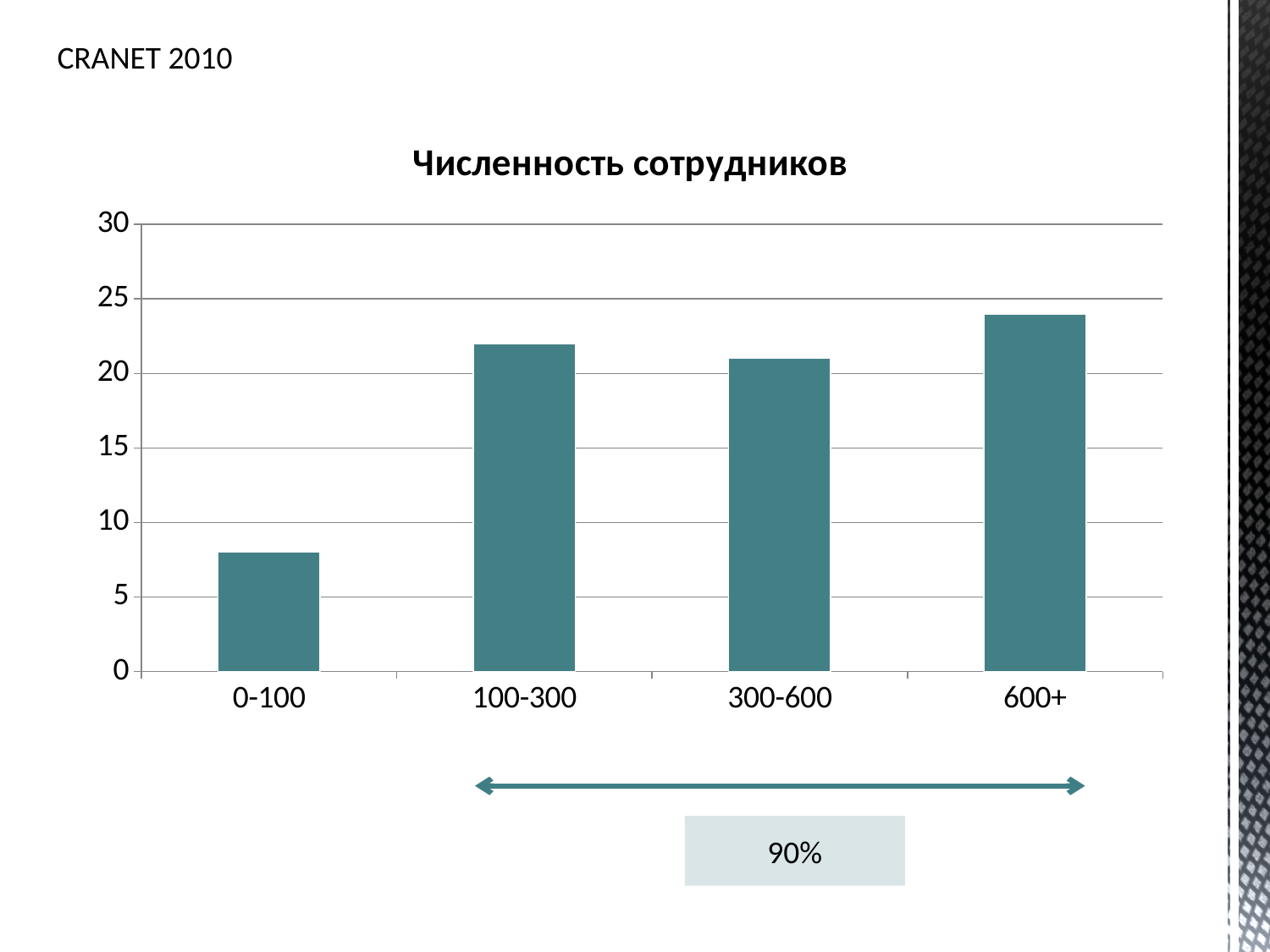
Is the value for 0-100 greater or less than 10? less What is the title of the chart? Численность сотрудников Which category has the highest bar? 600+ Is the value for 100-300 greater or less than 20? greater How many categories are shown on the x axis of the chart? 4 What is the highest value shown on the vertical axis? 30 Is the value for 300-600 greater or less than 15? greater What kind of chart is shown on the slide? bar chart Which is larger, the value for 0-100 or the value for 600+? 600+ Which is larger, the value for 0-100 or the value for 100-300? 100-300 Which category has the lowest bar? 0-100